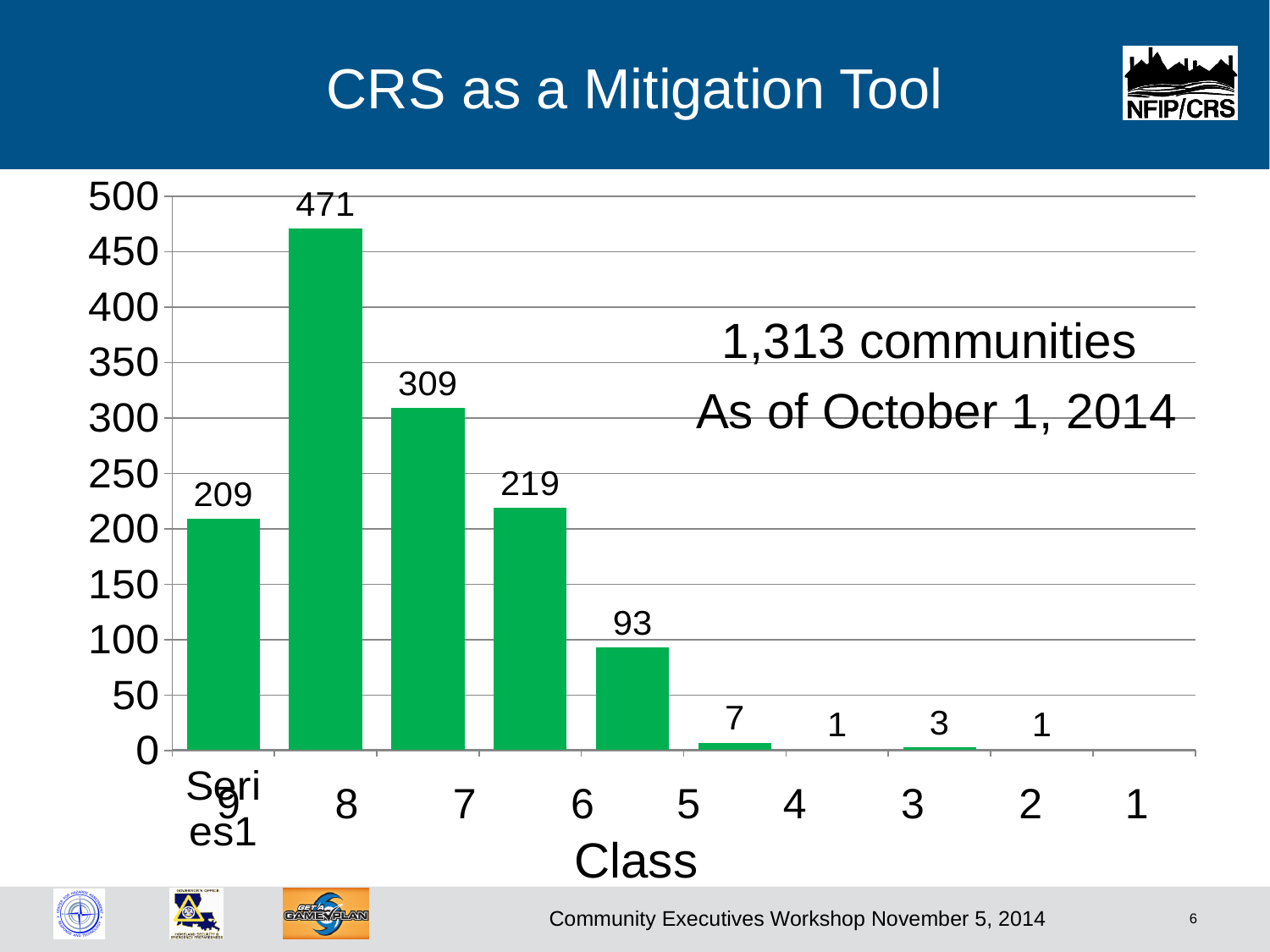
What is the value for Class 3? 1 What is the difference between the values for Class 8 and Class 7? 162 Is the value for Class 8 greater or less than 450? greater How many classes are shown on the x axis? 9 Which class has the highest value? 8 What is the value for Class 5? 93 What kind of chart is shown on the slide? bar chart What is the label of the x axis? Class What is the value for Class 8? 471 What is the difference between the values for Class 9 and Class 6? 10 Which is larger, the value for Class 7 or the value for Class 9? Class 7 What is the value for Class 6? 219